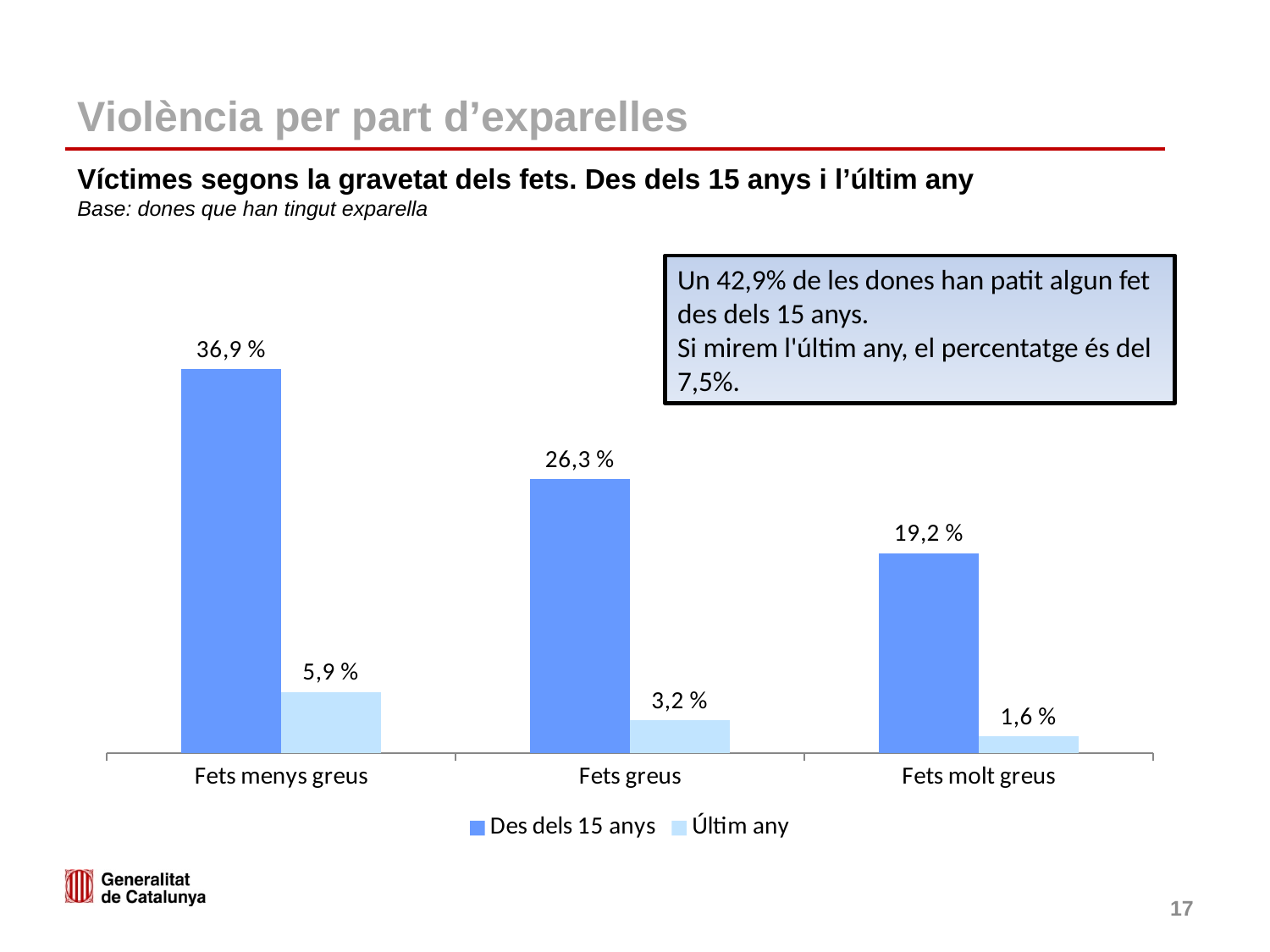
What kind of chart is shown on the slide? Bar chart What is the value for 'Fets molt greus' in the 'Des dels 15 anys' series? 19,2 % What is the value for 'Fets menys greus' in the 'Des dels 15 anys' series? 36,9 % Which category has the highest value in the 'Des dels 15 anys' series? Fets menys greus Which is larger: the 'Últim any' value for 'Fets menys greus' or for 'Fets greus'? Fets menys greus Which category has the lowest value in the 'Últim any' series? Fets molt greus How many series does the legend list? 2 What is the difference between the 'Des dels 15 anys' values for 'Fets menys greus' and 'Fets greus'? 10,6 % How many categories are shown on the x axis? 3 What is the value for 'Fets greus' in the 'Últim any' series? 3,2 % What is the difference between the 'Des dels 15 anys' and 'Últim any' values for 'Fets molt greus'? 17,6 % Do the 'Des dels 15 anys' values rise or fall from left to right along the x axis? Fall